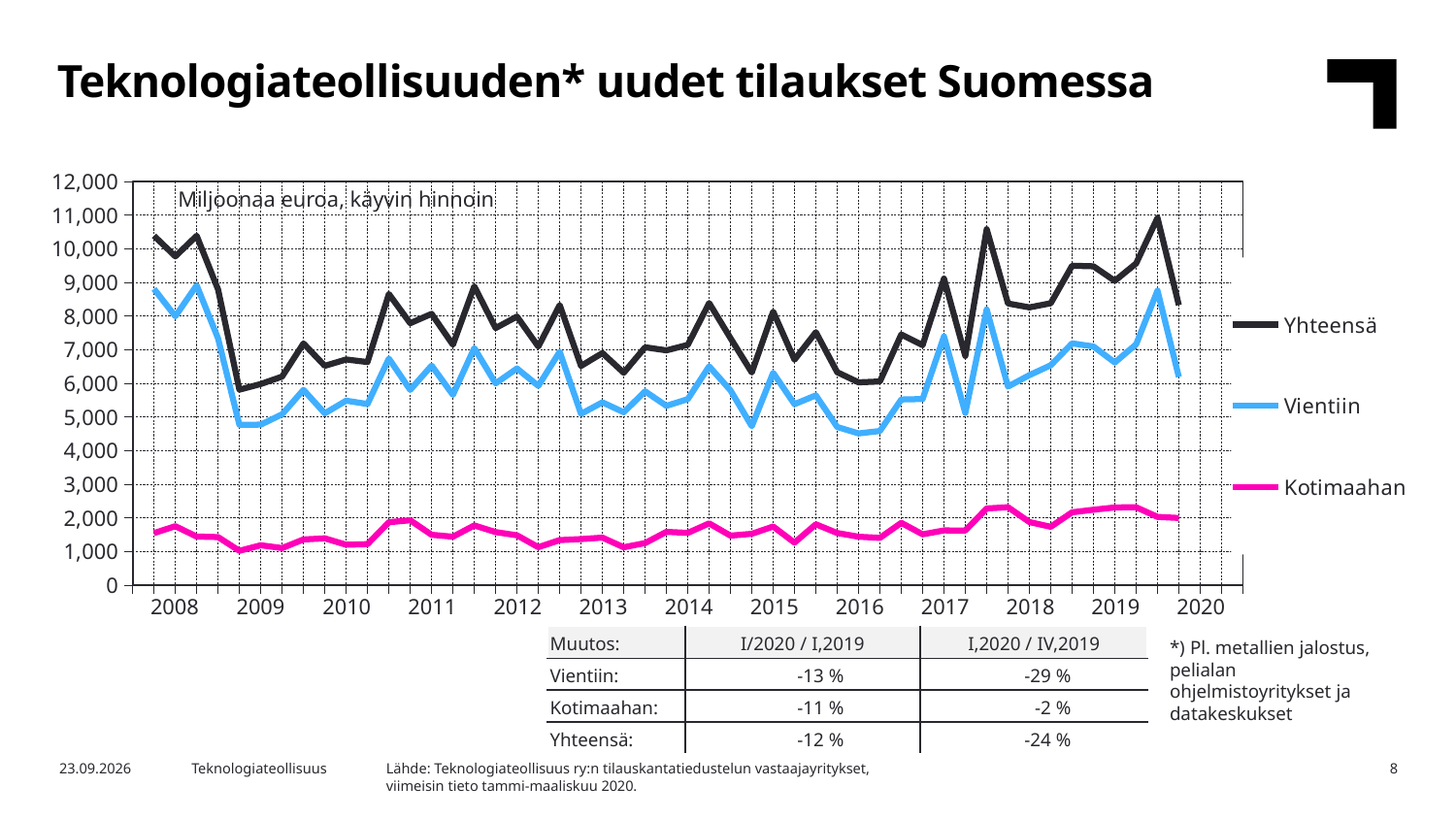
Which series has the lowest values across the whole period? Kotimaahan Is the Kotimaahan value at 2020 greater or less than 3,000? less What kind of chart is shown on the slide? line chart Is the Vientiin value at 2020 greater or less than 7,000? less What unit is stated in the label inside the chart area? Miljoonaa euroa, käyvin hinnoin How many series does the legend list? 3 How many year labels are shown on the x axis? 13 At 2020, which is larger, Yhteensä or Vientiin? Yhteensä Does the Yhteensä line rise or fall from its late-2019 peak to 2020? fall What are the three series named in the legend? Yhteensä, Vientiin, Kotimaahan Which series has the highest values across the whole period? Yhteensä Is the Yhteensä value at the start of 2008 greater or less than 10,000? greater